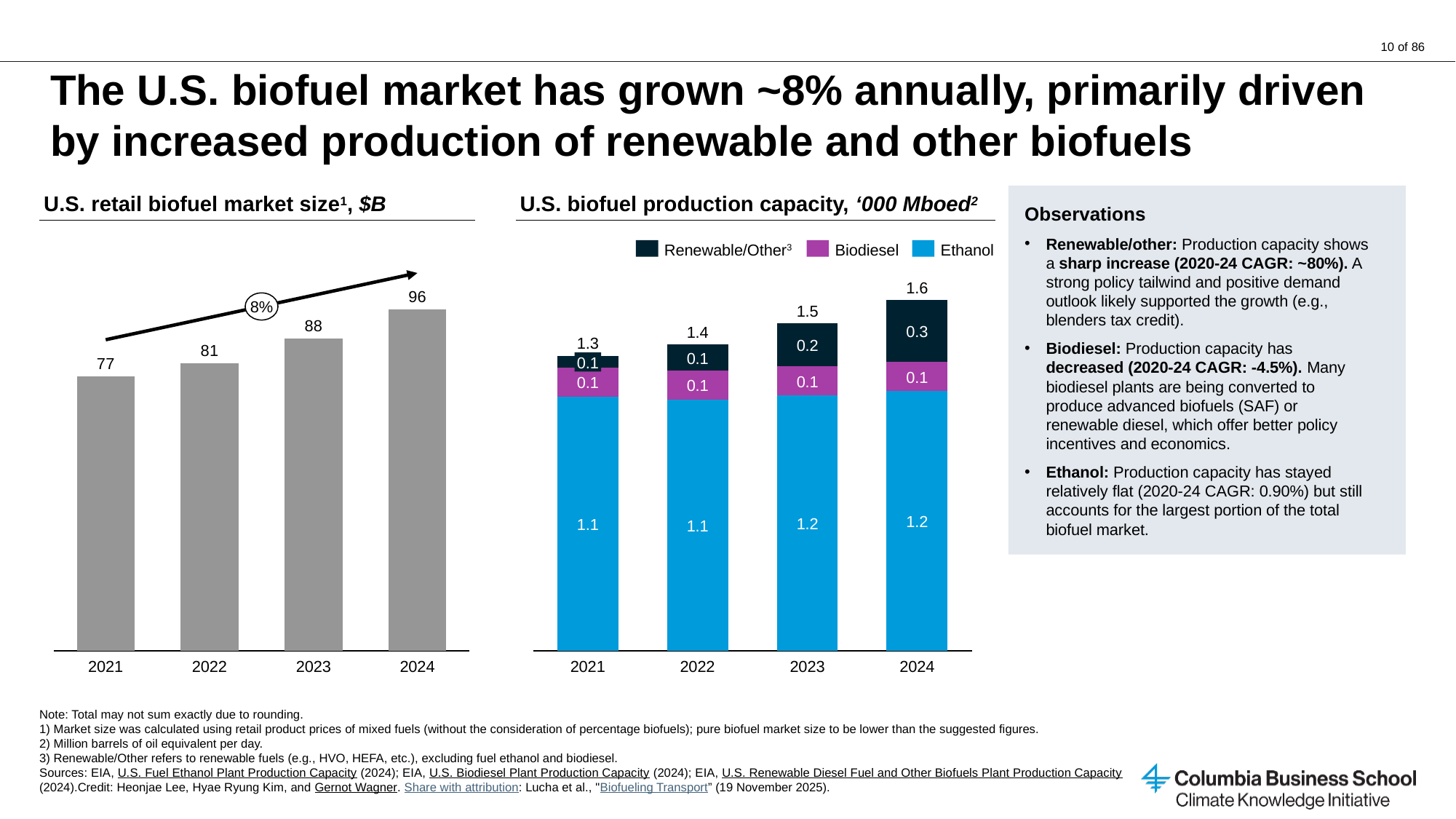
In the 'U.S. retail biofuel market size' chart, what is the difference between the 2024 and 2021 values? 19 In the 'U.S. biofuel production capacity' chart, what is the total for the 2023 bar? 1.5 In the 'U.S. retail biofuel market size' chart, what is the value for 2021? 77 In the 'U.S. biofuel production capacity' chart, how many series does the legend list? 3 In the 'U.S. retail biofuel market size' chart, what growth rate is shown in the circle on the arrow? 8% In the 'U.S. biofuel production capacity' chart, which is larger: the Renewable/Other value for 2024 or for 2021? 2024 In the 'U.S. biofuel production capacity' chart, what is the Ethanol value for 2022? 1.1 In the 'U.S. biofuel production capacity' chart, what is the Renewable/Other value for 2024? 0.3 In the 'U.S. retail biofuel market size' chart, how many years are shown? 4 In the 'U.S. retail biofuel market size' chart, do the values rise or fall from 2021 to 2024? rise In the 'U.S. retail biofuel market size' chart, which year has the highest value? 2024 What kind of chart is the 'U.S. biofuel production capacity' chart? stacked bar chart